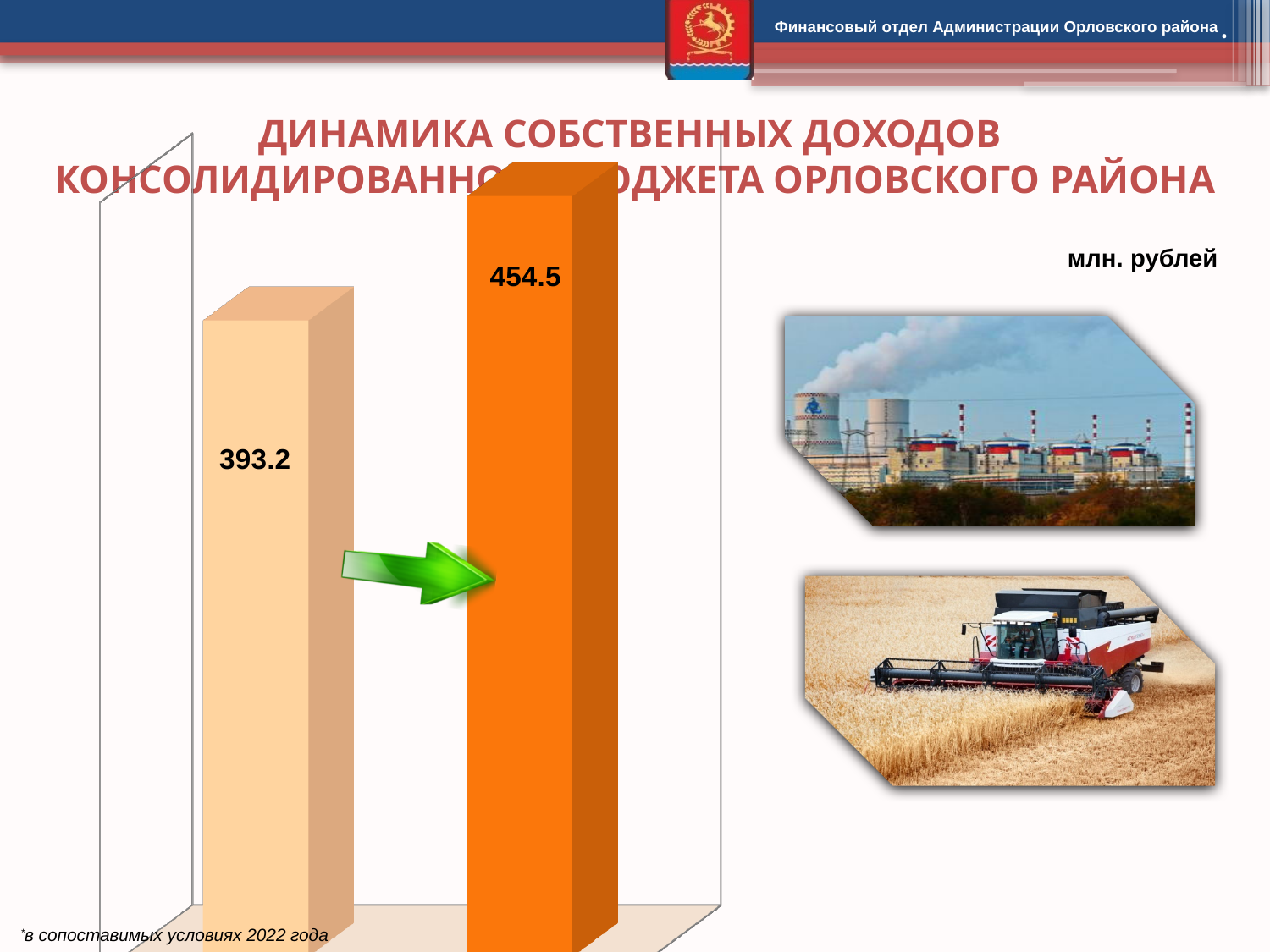
What colour is the bar with the value 454.5? dark orange Which bar has the lower value, the left one or the right one? the left one What kind of chart is shown on the slide? bar chart How many bars are plotted in the chart? 2 Do the values rise or fall from the left bar to the right bar? rise Which bar has the higher value, the left one or the right one? the right one Is the value of the dark orange bar larger or smaller than the value of the light orange bar? larger What value is shown on the left (light orange) bar? 393.2 What is the difference between the right bar's value (454.5) and the left bar's value (393.2)? 61.3 What value is shown on the right (dark orange) bar? 454.5 In what units are the chart values expressed, according to the label on the slide? млн. рублей